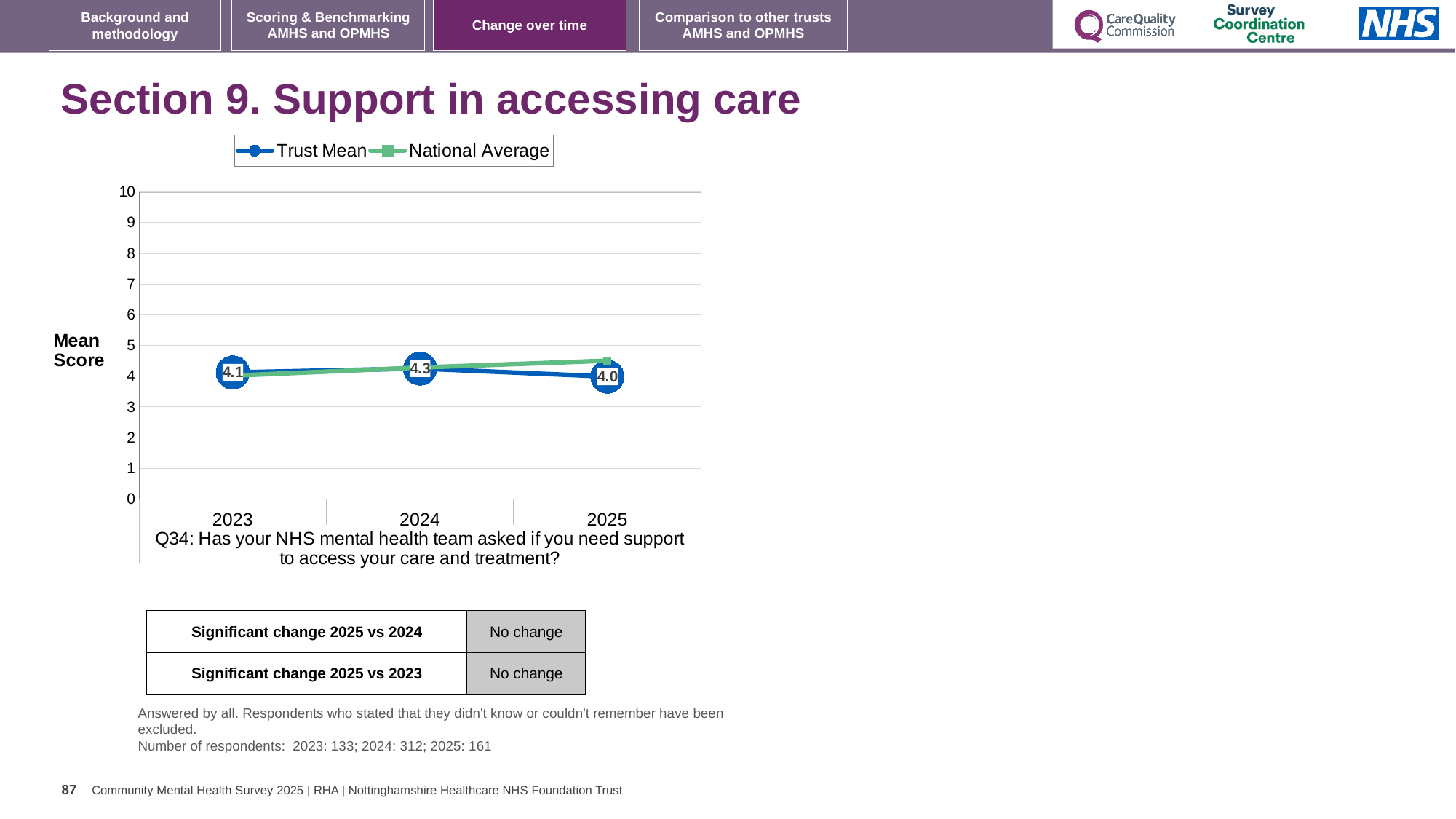
Does the Trust Mean rise or fall from 2024 to 2025? fall What is the Trust Mean value for 2023? 4.1 In which year is the Trust Mean highest? 2024 What is the difference between the Trust Mean in 2024 and in 2025? 0.3 What is the Trust Mean value for 2025? 4.0 How many years are shown on the x axis of the chart? 3 What kind of chart is shown on the slide? line chart Which is larger, the Trust Mean for 2023 or for 2024? 2024 How many series does the chart legend list? 2 Is the National Average value for 2025 greater or less than 5? less In which year is the Trust Mean lowest? 2025 What is the Trust Mean value for 2024? 4.3